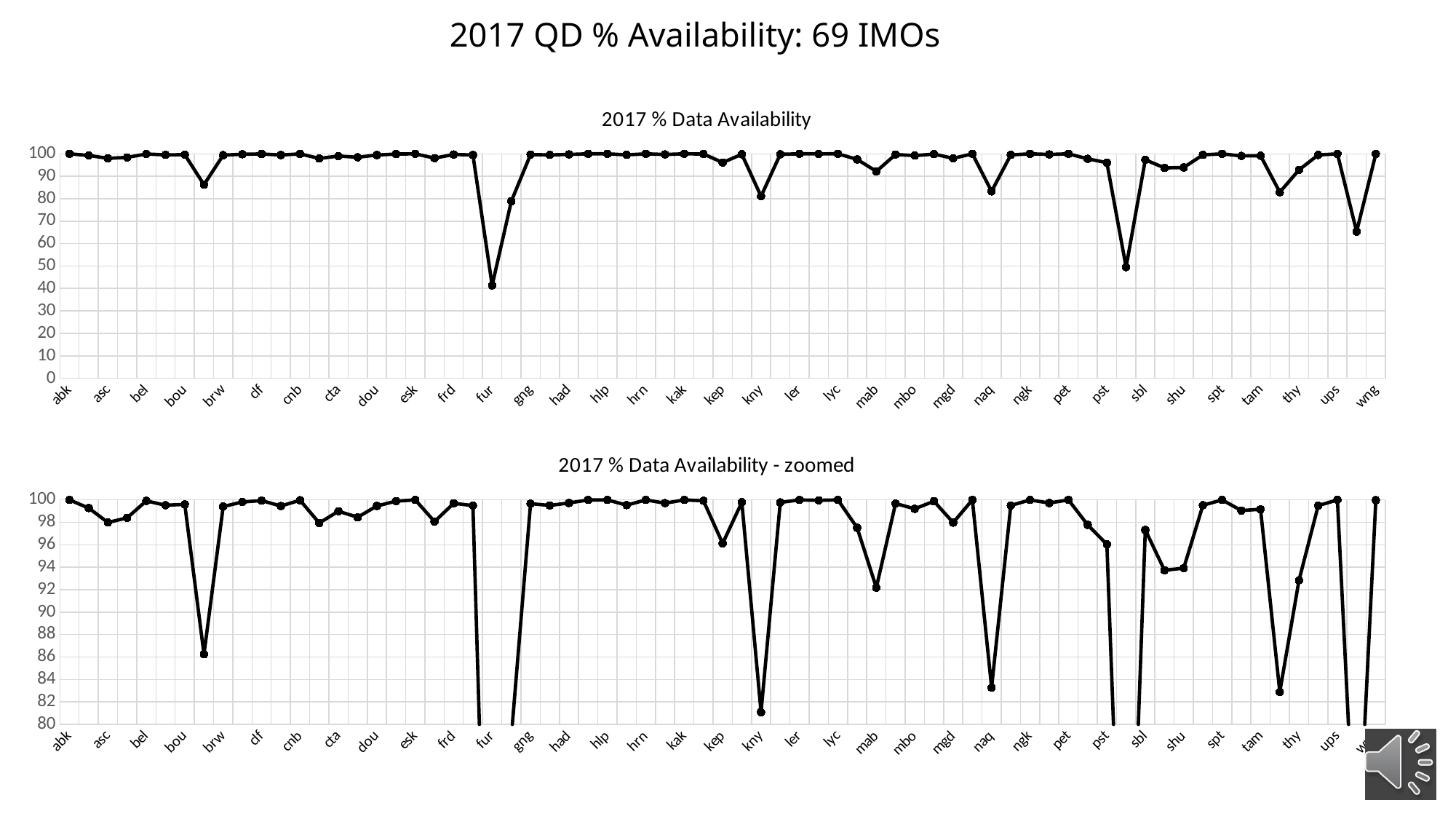
In the bottom chart '2017 % Data Availability - zoomed', is the value for shu greater or less than 96? less In the top chart '2017 % Data Availability', which is larger, the value for fur or the value for naq? naq According to the slide title, how many IMOs are covered by the charts? 69 In the bottom chart '2017 % Data Availability - zoomed', is the value for kep greater or less than 98? less In the top chart '2017 % Data Availability', which labelled IMO has the lowest availability? fur In the top chart '2017 % Data Availability', is the value for kep greater or less than 90? greater In the bottom chart '2017 % Data Availability - zoomed', which is larger, the value for brw or the value for kny? brw What kind of chart is the top chart titled '2017 % Data Availability'? line chart